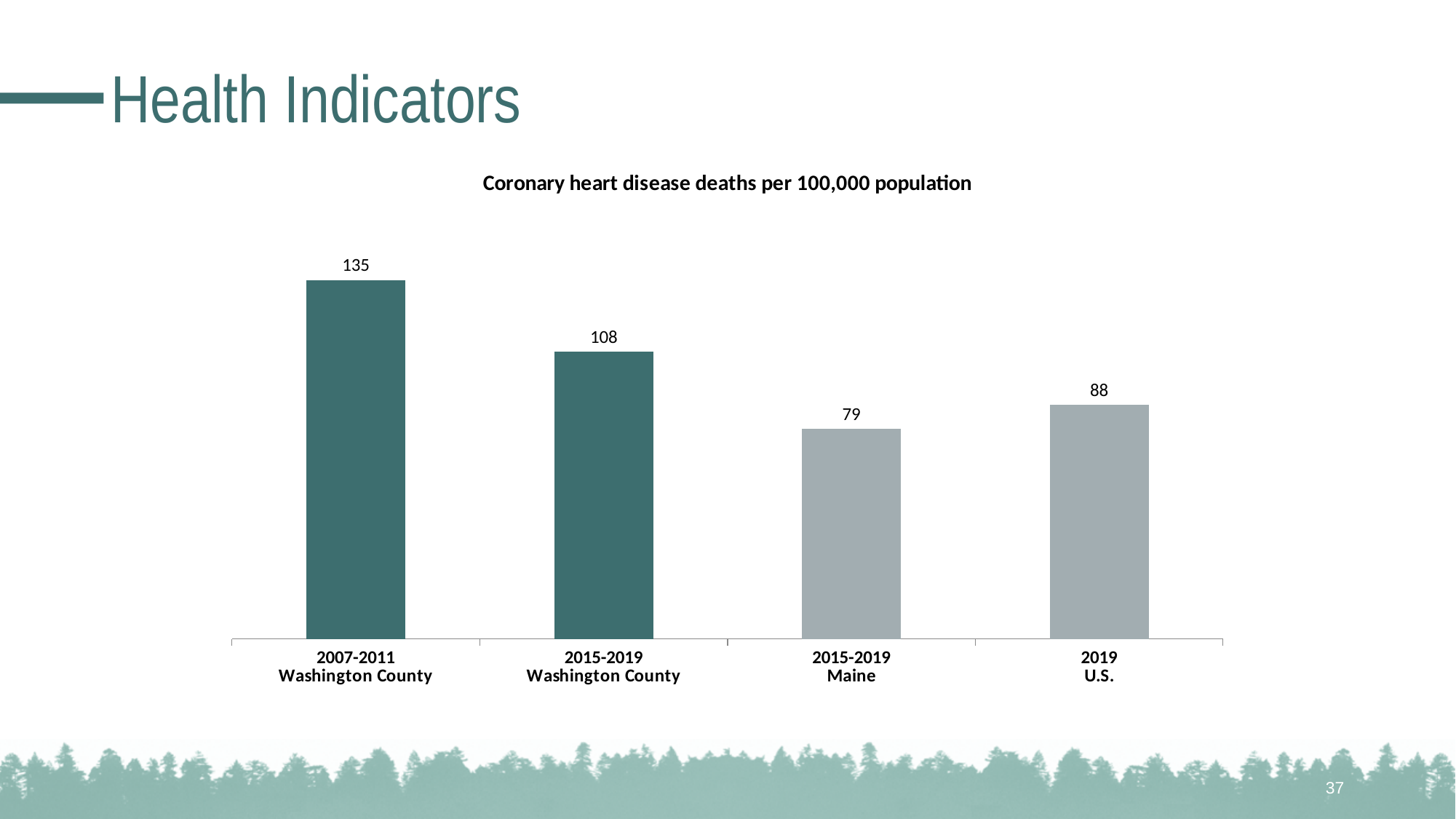
What is the title of the chart? Coronary heart disease deaths per 100,000 population What is the value for 2015-2019 Maine? 79 What is the value for 2007-2011 Washington County? 135 What is the value for 2019 U.S.? 88 What kind of chart is shown on the slide? Bar chart Which category has the lowest value? 2015-2019 Maine What is the difference between the 2007-2011 Washington County value and the 2015-2019 Washington County value? 27 What is the difference between the 2019 U.S. value and the 2015-2019 Maine value? 9 How many categories are shown in the chart? 4 Which category has the highest value? 2007-2011 Washington County Which is larger, the value for 2015-2019 Washington County or the value for 2019 U.S.? 2015-2019 Washington County What is the value for 2015-2019 Washington County? 108